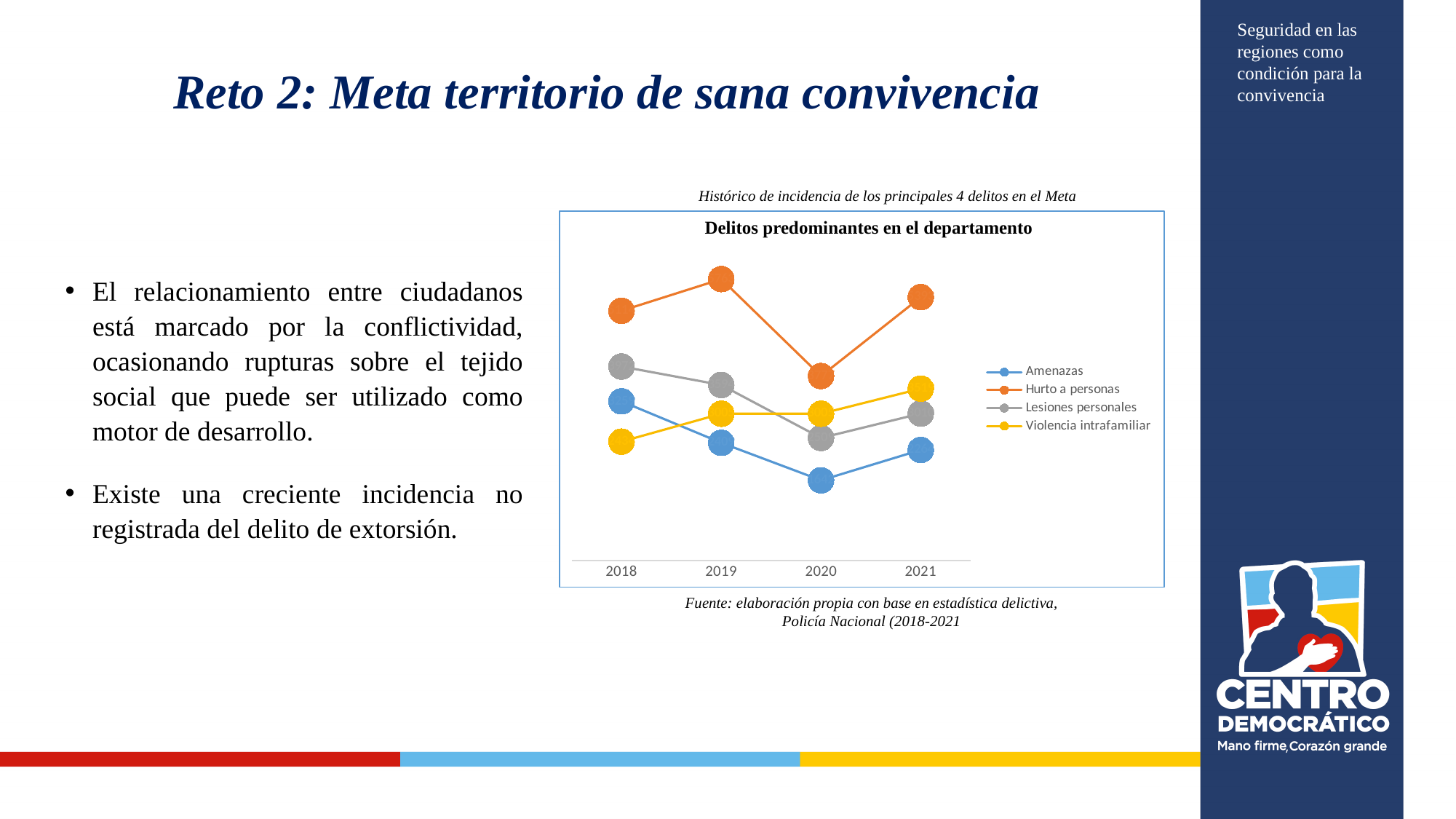
What is the title of the chart? Delitos predominantes en el departamento How many years are shown on the x axis of the chart? 4 Does the Violencia intrafamiliar series rise or fall from 2018 to 2021? Rise What kind of chart is shown on the slide? Line chart In 2018, which is larger: Hurto a personas or Amenazas? Hurto a personas Does the Amenazas series rise or fall from 2018 to 2020? Fall How many series does the legend of the chart list? 4 Which colour is used for the Hurto a personas series? Orange Which series has the lowest value in 2020? Amenazas Which series has the lowest value in 2018? Violencia intrafamiliar In 2021, which is larger: Violencia intrafamiliar or Lesiones personales? Violencia intrafamiliar Which series has the highest value in 2019? Hurto a personas